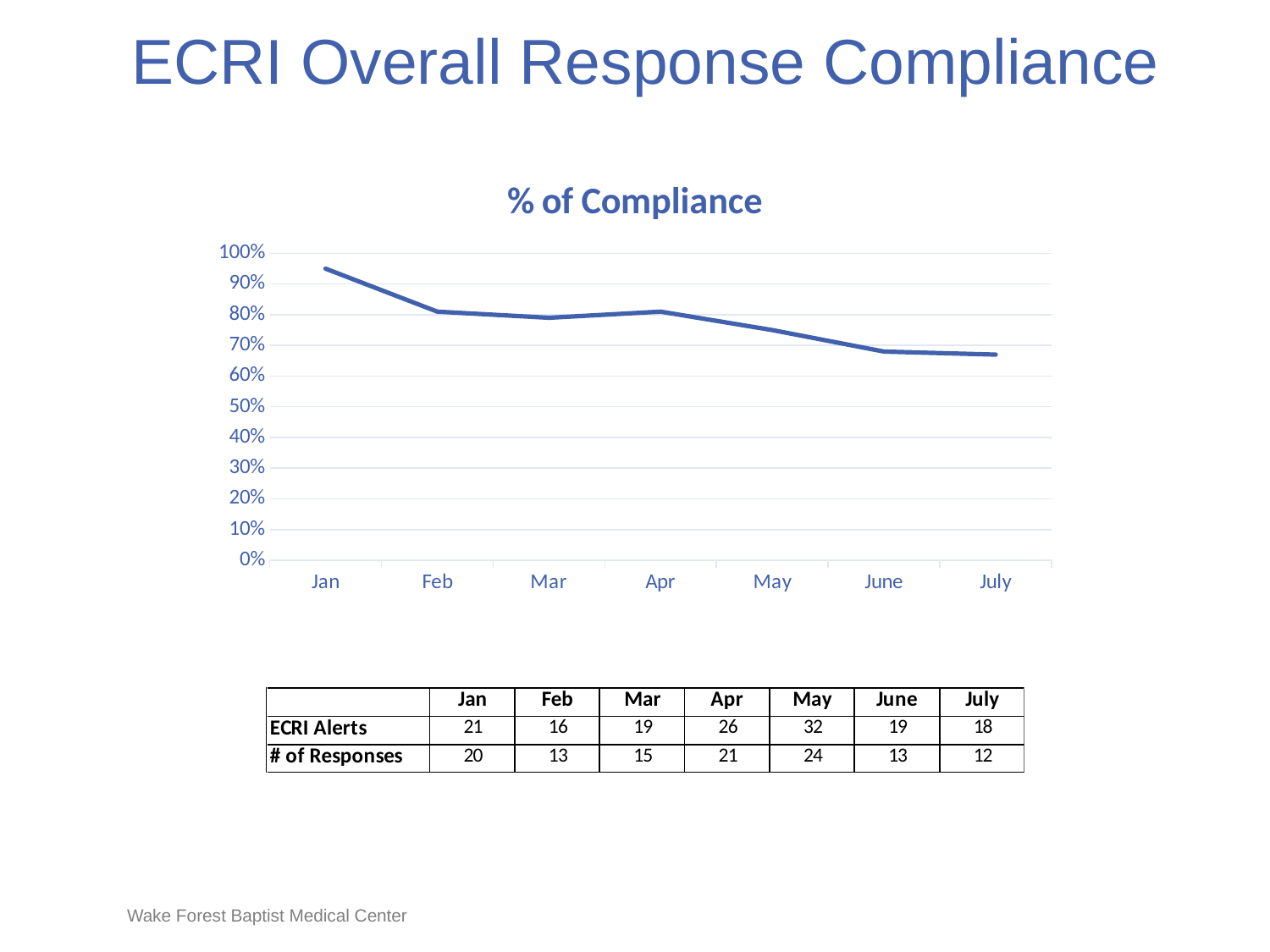
Which month has the highest % of Compliance? Jan How many months are plotted on the x axis of the chart? 7 Is the % of Compliance for Feb greater or less than 90%? less Is the % of Compliance for May greater or less than 80%? less Is the % of Compliance for July greater or less than 70%? less What kind of chart is shown on the slide? line chart Overall, does the % of Compliance rise or fall from Jan to July? fall Which month has a higher % of Compliance, Jan or May? Jan Which month has a higher % of Compliance, Feb or June? Feb What is the title of the chart? % of Compliance